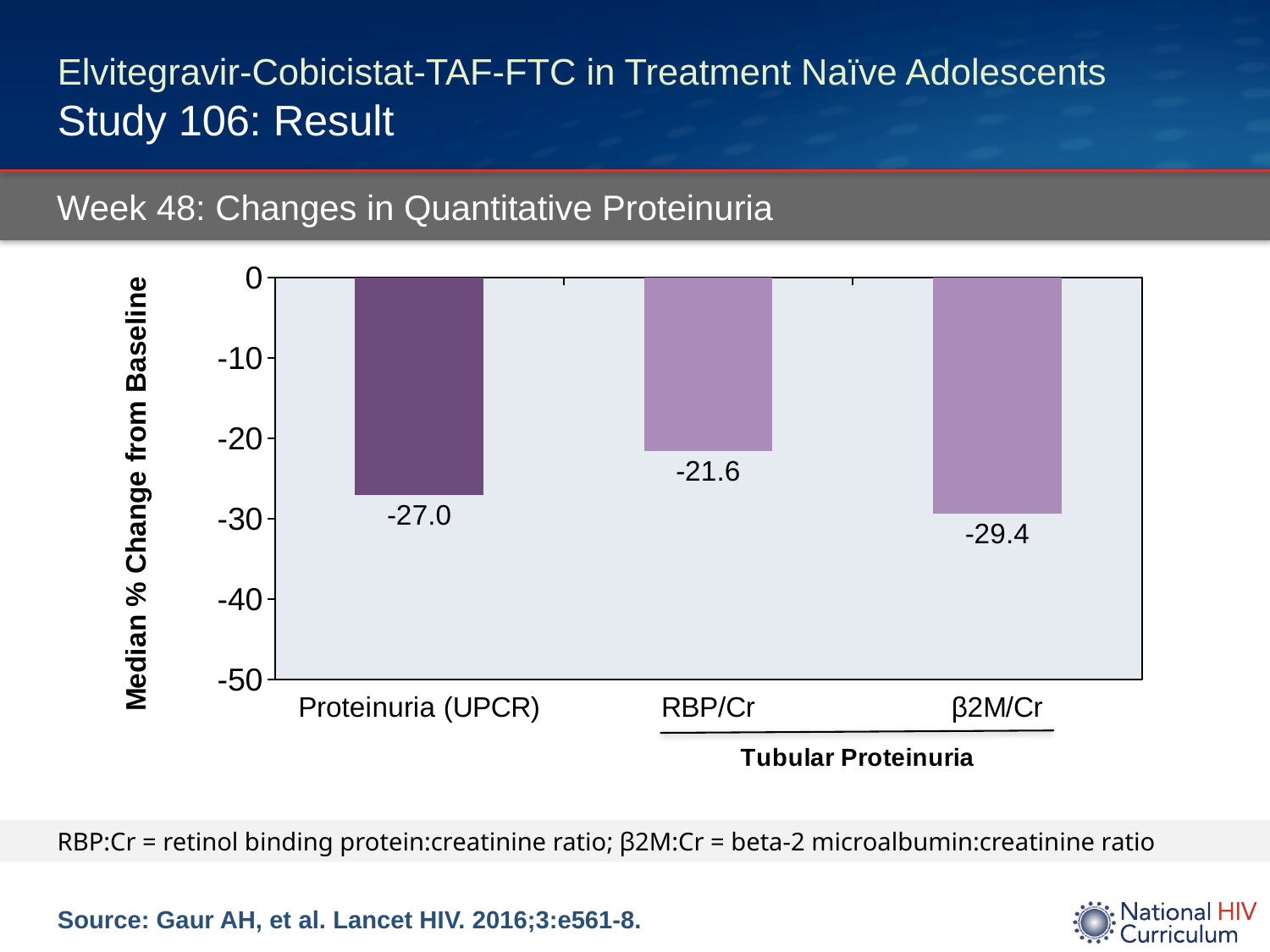
Which category shows the smallest decrease from baseline? RBP/Cr What is the median % change from baseline for Proteinuria (UPCR)? -27.0 Which two categories are grouped under the label 'Tubular Proteinuria'? RBP/Cr and β2M/Cr What is the median % change from baseline for β2M/Cr? -29.4 Which has a larger decrease from baseline, Proteinuria (UPCR) or RBP/Cr? Proteinuria (UPCR) Which category shows the largest decrease from baseline? β2M/Cr What is the difference between the values for β2M/Cr and RBP/Cr? 7.8 What is the median % change from baseline for RBP/Cr? -21.6 How many categories are shown on the chart? 3 Is the value for β2M/Cr greater or less than -20? less What kind of chart is shown on the slide? Bar chart What is the difference between the values for Proteinuria (UPCR) and RBP/Cr? 5.4